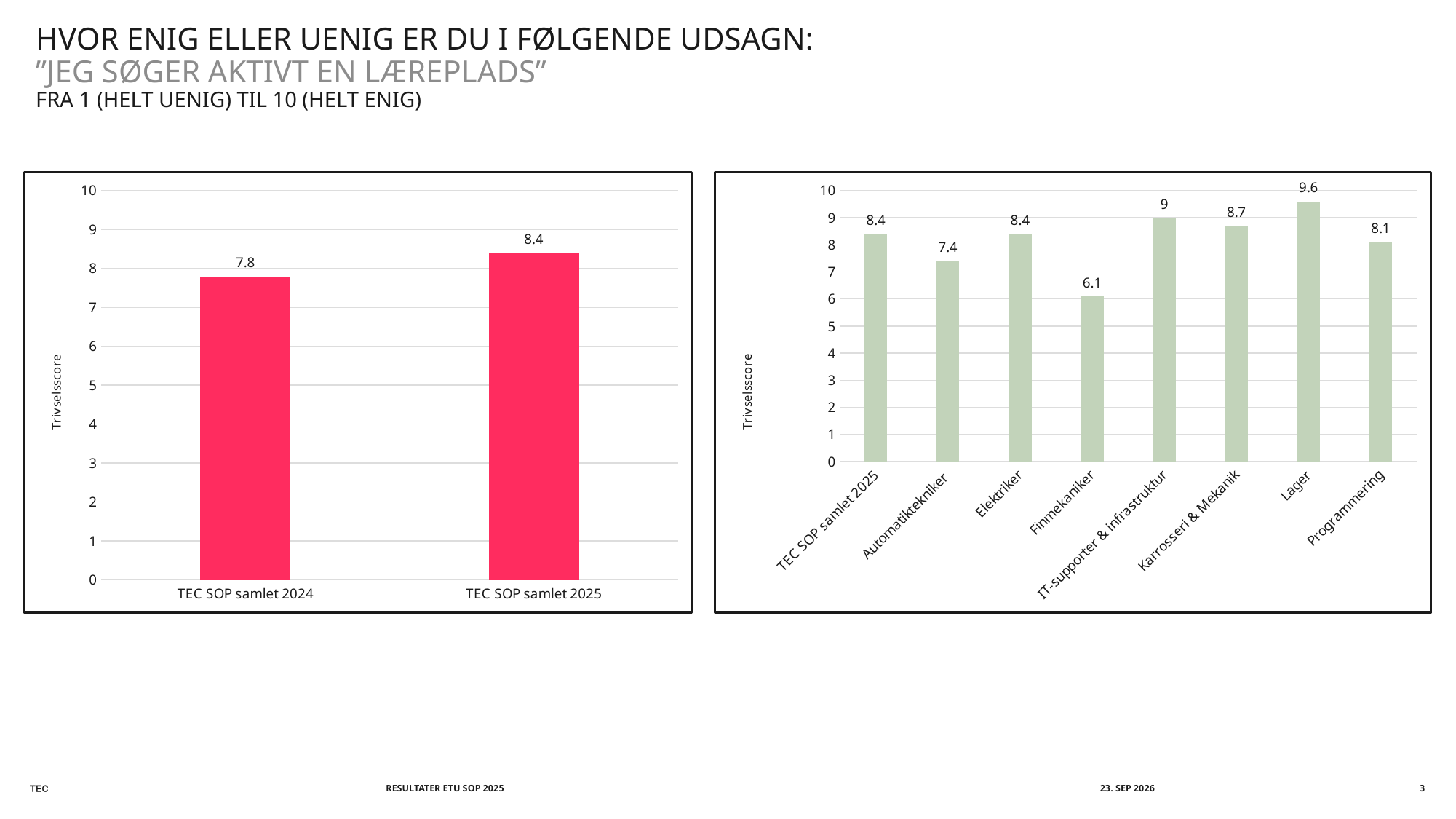
In the right chart, which category has the highest value? Lager In the left chart, what is the value for TEC SOP samlet 2024? 7.8 In the right chart, what is the value for Karrosseri & Mekanik? 8.7 In the right chart, how many categories are shown on the x axis? 8 In the left chart, what is the value for TEC SOP samlet 2025? 8.4 In the left chart, what is the difference between TEC SOP samlet 2025 and TEC SOP samlet 2024? 0.6 In the right chart, what is the value for Finmekaniker? 6.1 In the right chart, which is larger: IT-supporter & infrastruktur or Programmering? IT-supporter & infrastruktur In the left chart, how many bars are plotted? 2 What kind of chart is the right chart? bar chart In the left chart, do the values rise or fall from 2024 to 2025? rise In the right chart, which category has the lowest value? Finmekaniker